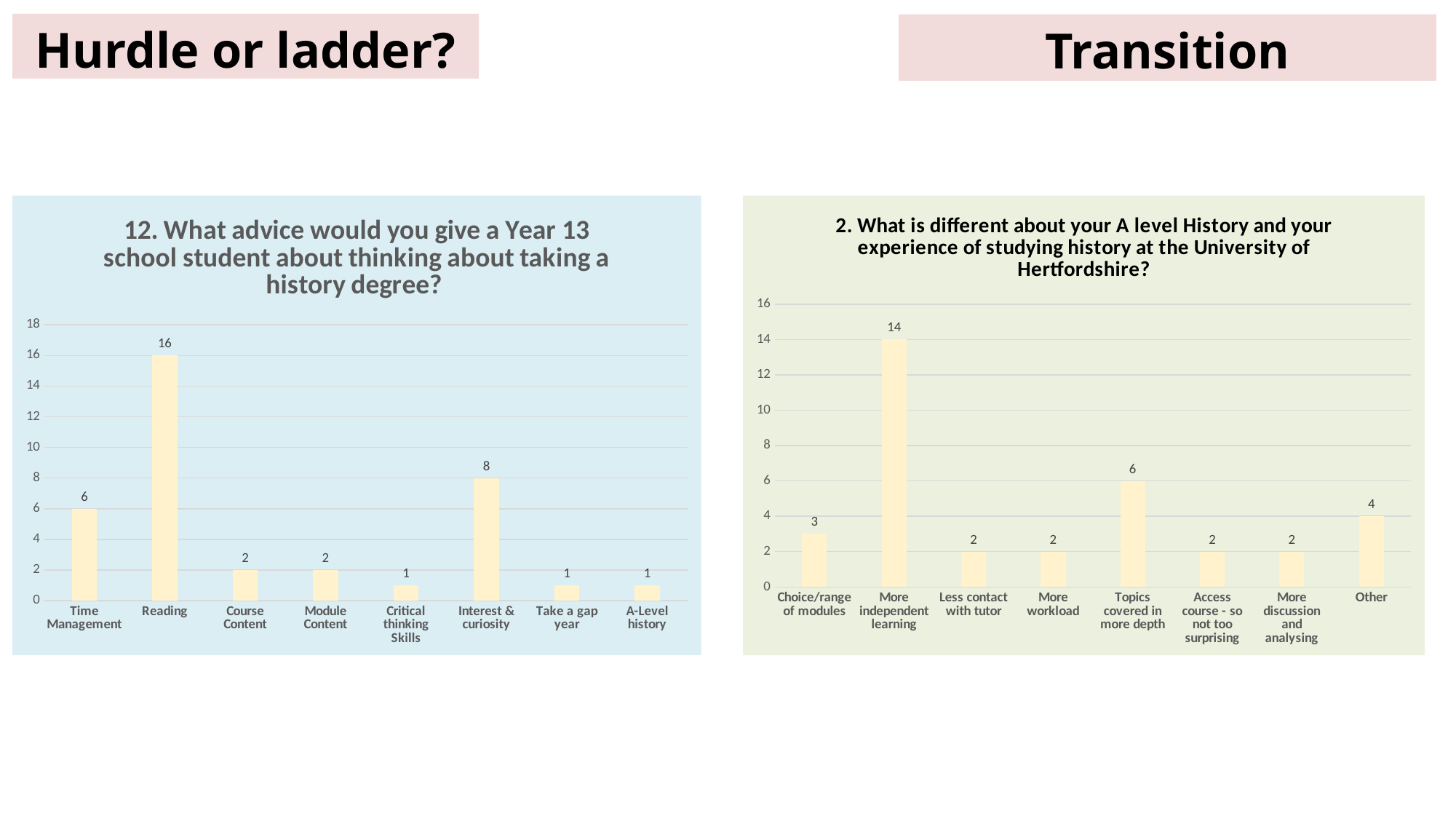
In the right chart (question 2, differences between A level and university history), how many categories are shown on the x axis? 8 In the left chart (question 12, advice for a Year 13 student), is the value for Time Management greater or less than 4? greater In the right chart (question 2, differences between A level and university history), what is the value for More independent learning? 14 In the right chart (question 2, differences between A level and university history), what is the value for Other? 4 In the left chart (question 12, advice for a Year 13 student), what is the difference between Reading and Time Management? 10 In the left chart (question 12, advice for a Year 13 student), how many categories are shown on the x axis? 8 In the left chart (question 12, advice for a Year 13 student), what is the value for Reading? 16 In the left chart (question 12, advice for a Year 13 student), which category has the highest value? Reading In the left chart (question 12, advice for a Year 13 student), what is the value for Interest & curiosity? 8 In the right chart (question 2, differences between A level and university history), what is the difference between More independent learning and Topics covered in more depth? 8 In the right chart (question 2, differences between A level and university history), which is larger: Topics covered in more depth or Choice/range of modules? Topics covered in more depth What type of chart is the right chart (question 2, differences between A level and university history)? Bar chart